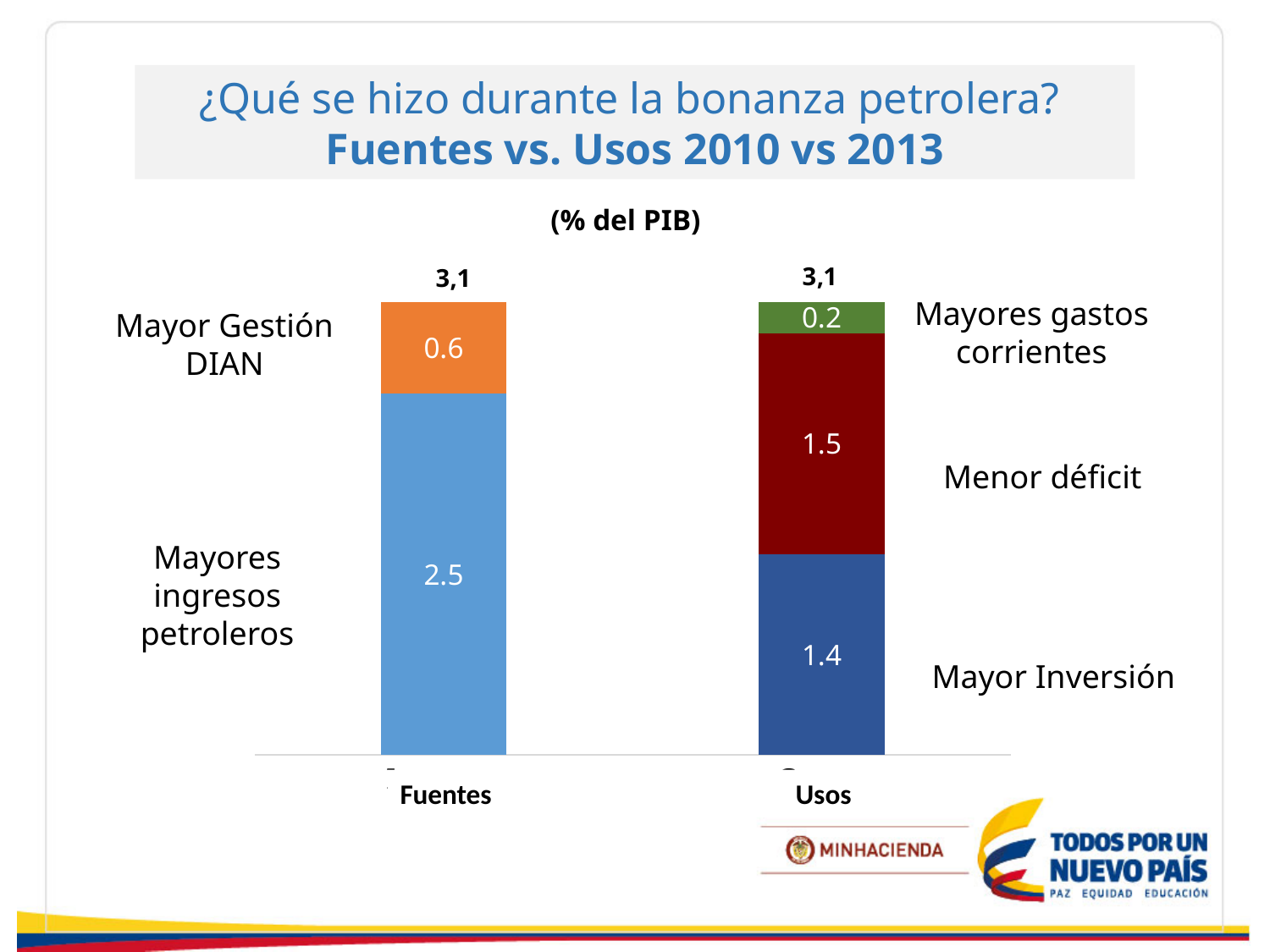
Which segment in the Usos bar is the smallest? Mayores gastos corrientes Which segment in the Fuentes bar is the largest? Mayores ingresos petroleros What is the value of the Mayores gastos corrientes segment in the Usos bar? 0.2 What is the total of the Fuentes bar? 3,1 What is the total of the Usos bar? 3,1 What is the value of the Mayor Inversión segment in the Usos bar? 1.4 What kind of chart is shown on the slide? Stacked bar chart What is the value of the Mayores ingresos petroleros segment in the Fuentes bar? 2.5 What is the value of the Mayor Gestión DIAN segment in the Fuentes bar? 0.6 What is the difference between the Mayores ingresos petroleros segment (2.5) and the Mayor Inversión segment (1.4)? 1.1 What is the value of the Menor déficit segment in the Usos bar? 1.5 How many bars are plotted in the chart? 2